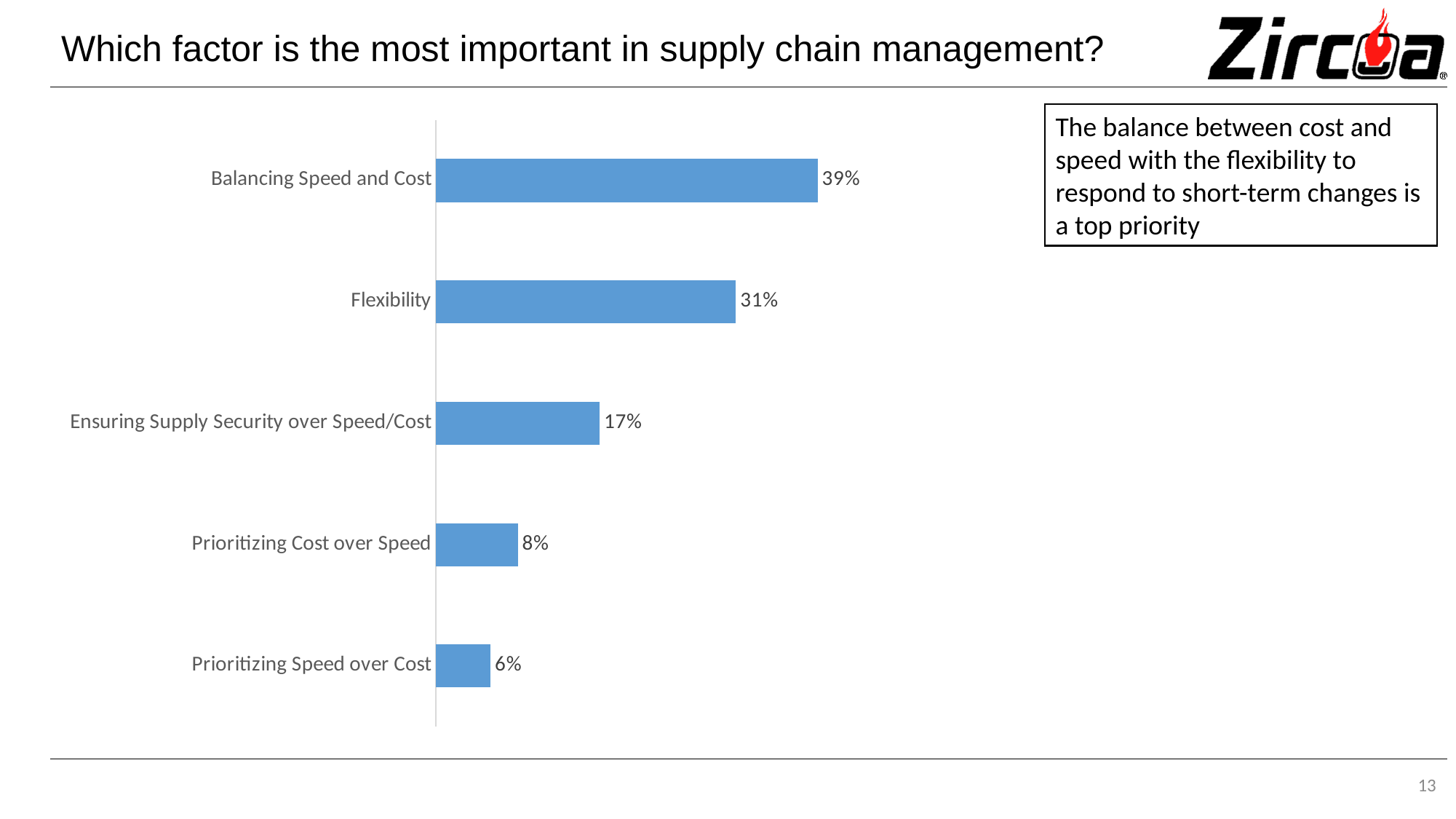
What type of chart is shown on the slide? Bar chart What is the value for Prioritizing Cost over Speed? 8% What percentage is shown for Ensuring Supply Security over Speed/Cost? 17% Which is larger: the value for Flexibility or the value for Ensuring Supply Security over Speed/Cost? Flexibility Which factor has the lowest percentage? Prioritizing Speed over Cost How many factors (categories) are shown in the chart? 5 What percentage of respondents chose Balancing Speed and Cost as the most important factor? 39% What is the value shown for Flexibility? 31% What colour are the bars in the chart? Blue Which factor has the highest percentage? Balancing Speed and Cost What is the difference between Prioritizing Cost over Speed and Prioritizing Speed over Cost? 2 percentage points What is the difference in percentage points between Balancing Speed and Cost and Flexibility? 8 percentage points